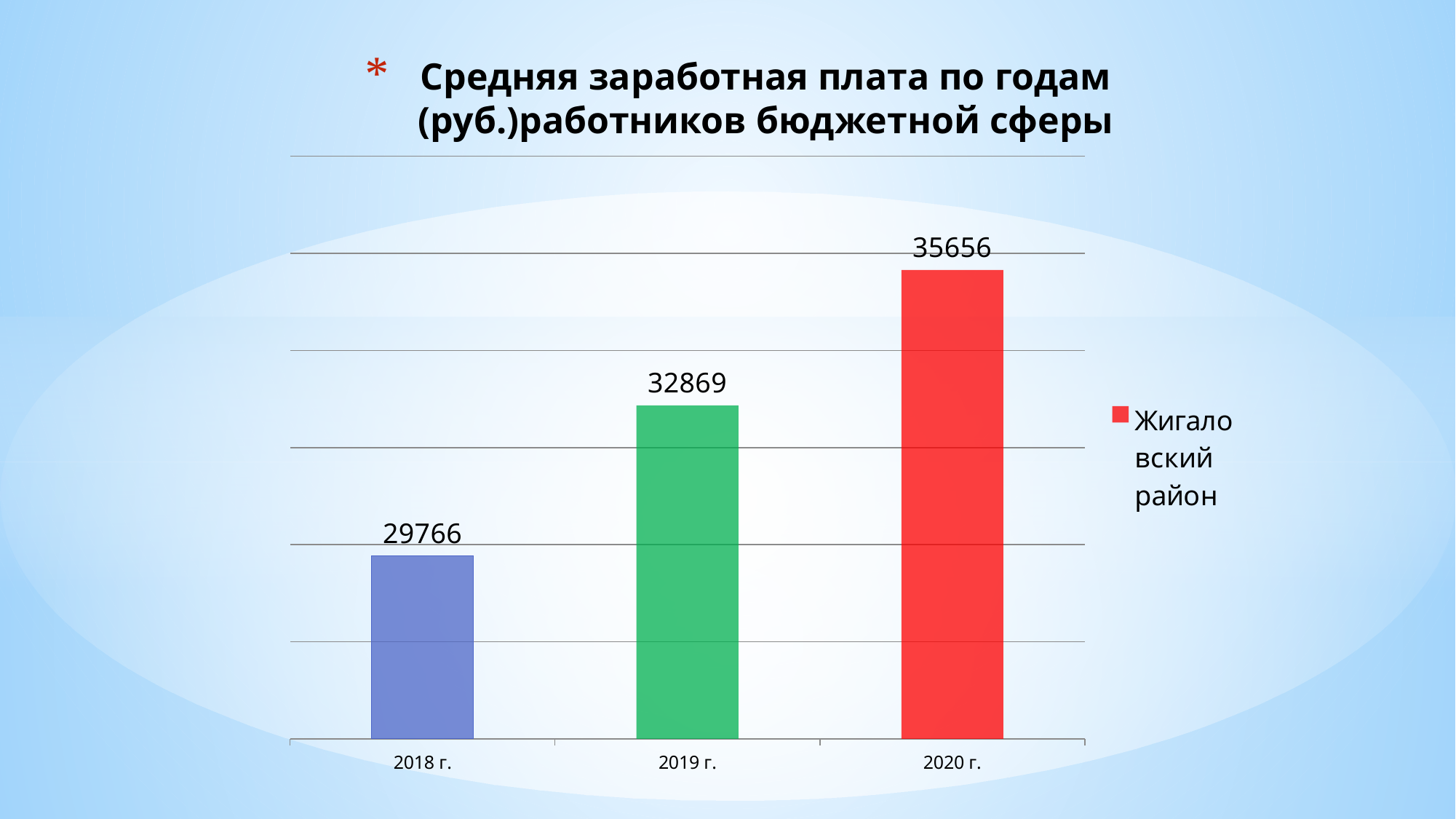
What is the difference between the values for 2020 г. and 2019 г.? 2787 Which year has the lowest value on the chart? 2018 г. What is the difference between the values for 2020 г. and 2018 г.? 5890 Which is larger, the value for 2019 г. or the value for 2020 г.? 2020 г. Do the values rise or fall from 2018 г. to 2020 г.? rise What is the value shown for 2020 г.? 35656 How many years (categories) are shown on the chart? 3 What is the difference between the values for 2019 г. and 2018 г.? 3103 What kind of chart is shown on the slide? bar chart Which year has the highest value on the chart? 2020 г. What is the average salary value shown for 2018 г.? 29766 What is the value shown for 2019 г.? 32869